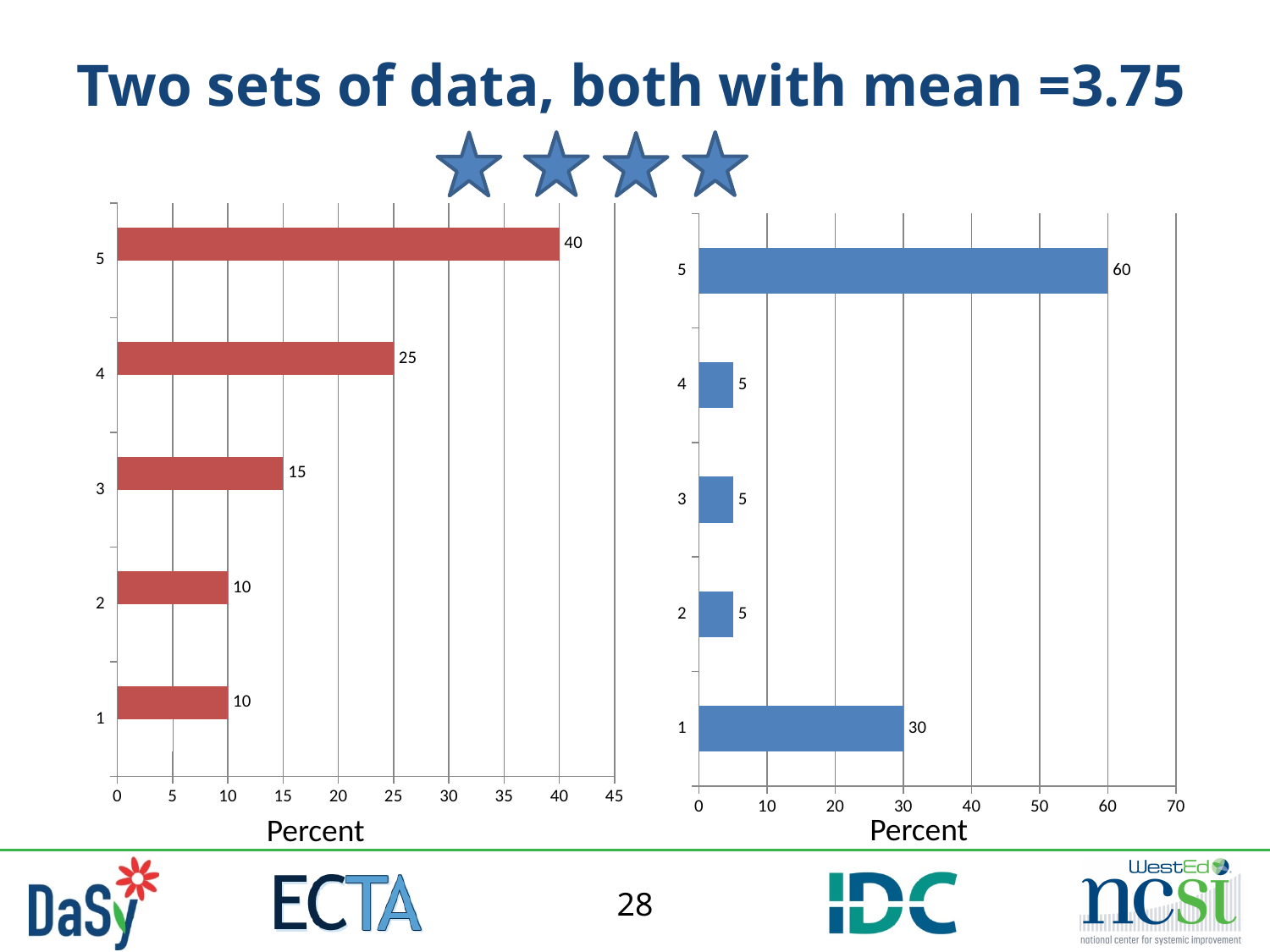
In the left chart, what is the percent value for category 5? 40 What is the x-axis label of the left chart? Percent In the left chart, what is the difference in percent between category 5 and category 4? 15 In the left chart, which category has the highest percent? 5 In the left chart, is the value for category 4 greater or less than 20? greater What colour are the bars in the right chart? blue In the right chart, what is the difference in percent between category 5 and category 1? 30 In the right chart, what is the percent value for category 1? 30 In the right chart, which is larger, the value for category 1 or the value for category 4? category 1 How many categories are shown in the left chart? 5 What kind of chart is the right chart? bar chart In the right chart, which category has the highest percent? 5